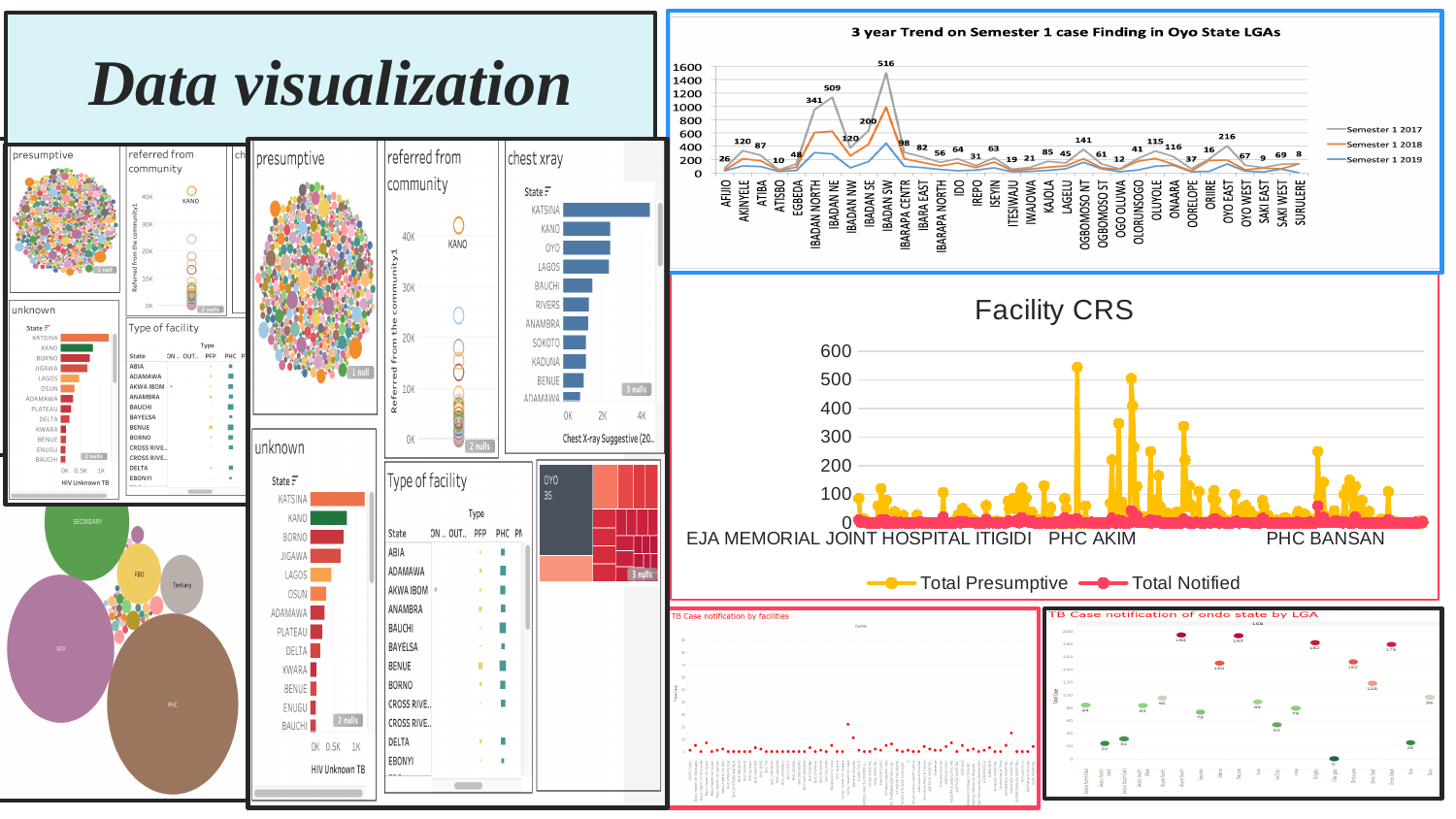
How many series does the legend of the 'Facility CRS' chart list? 2 What kind of chart is the '3 year Trend on Semester 1 case Finding in Oyo State LGAs' chart? Line chart In the 'chest xray' bar chart in the centre of the slide, which state has the longest bar? KATSINA In the chart titled '3 year Trend on Semester 1 case Finding in Oyo State LGAs', what is the labelled value for IBADAN NE? 509 In the chart titled '3 year Trend on Semester 1 case Finding in Oyo State LGAs', what is the difference between the labelled values for IBADAN SW and IBADAN NORTH? 175 In the chart titled '3 year Trend on Semester 1 case Finding in Oyo State LGAs', which LGA has the highest labelled value? IBADAN SW In the chart titled '3 year Trend on Semester 1 case Finding in Oyo State LGAs', what is the labelled value for IBADAN SW? 516 In the chart titled '3 year Trend on Semester 1 case Finding in Oyo State LGAs', which LGA has the lowest labelled value? SURULERE In the chart titled '3 year Trend on Semester 1 case Finding in Oyo State LGAs', which has the larger labelled value, OYO EAST or OGBOMOSO NT? OYO EAST How many series does the legend of the chart titled '3 year Trend on Semester 1 case Finding in Oyo State LGAs' list? 3 In the 'Facility CRS' chart, is the highest Total Presumptive value greater or less than 500? greater